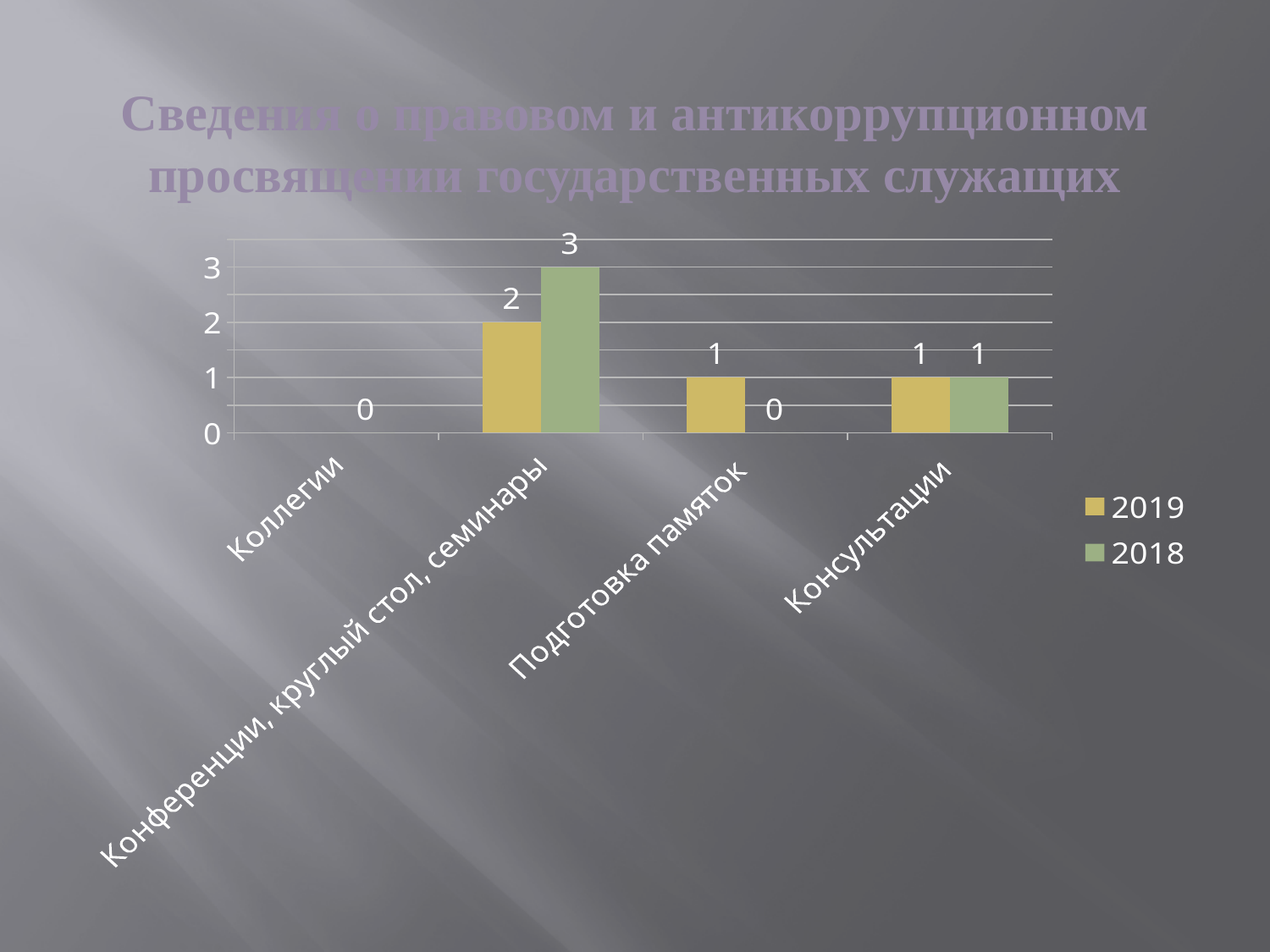
How many categories are shown on the x axis? 4 For Подготовка памяток, which series has the larger value, 2019 or 2018? 2019 What is the 2018 value for Подготовка памяток? 0 What is the 2018 value for Конференции, круглый стол, семинары? 3 What is the difference between the 2018 and 2019 values for Конференции, круглый стол, семинары? 1 How many series does the legend list? 2 What is the 2019 value for Подготовка памяток? 1 Which category has the highest 2018 value? Конференции, круглый стол, семинары What type of chart is shown on the slide? bar chart Which legend entry is shown in green? 2018 What is the 2019 value for Конференции, круглый стол, семинары? 2 What is the 2018 value for Консультации? 1